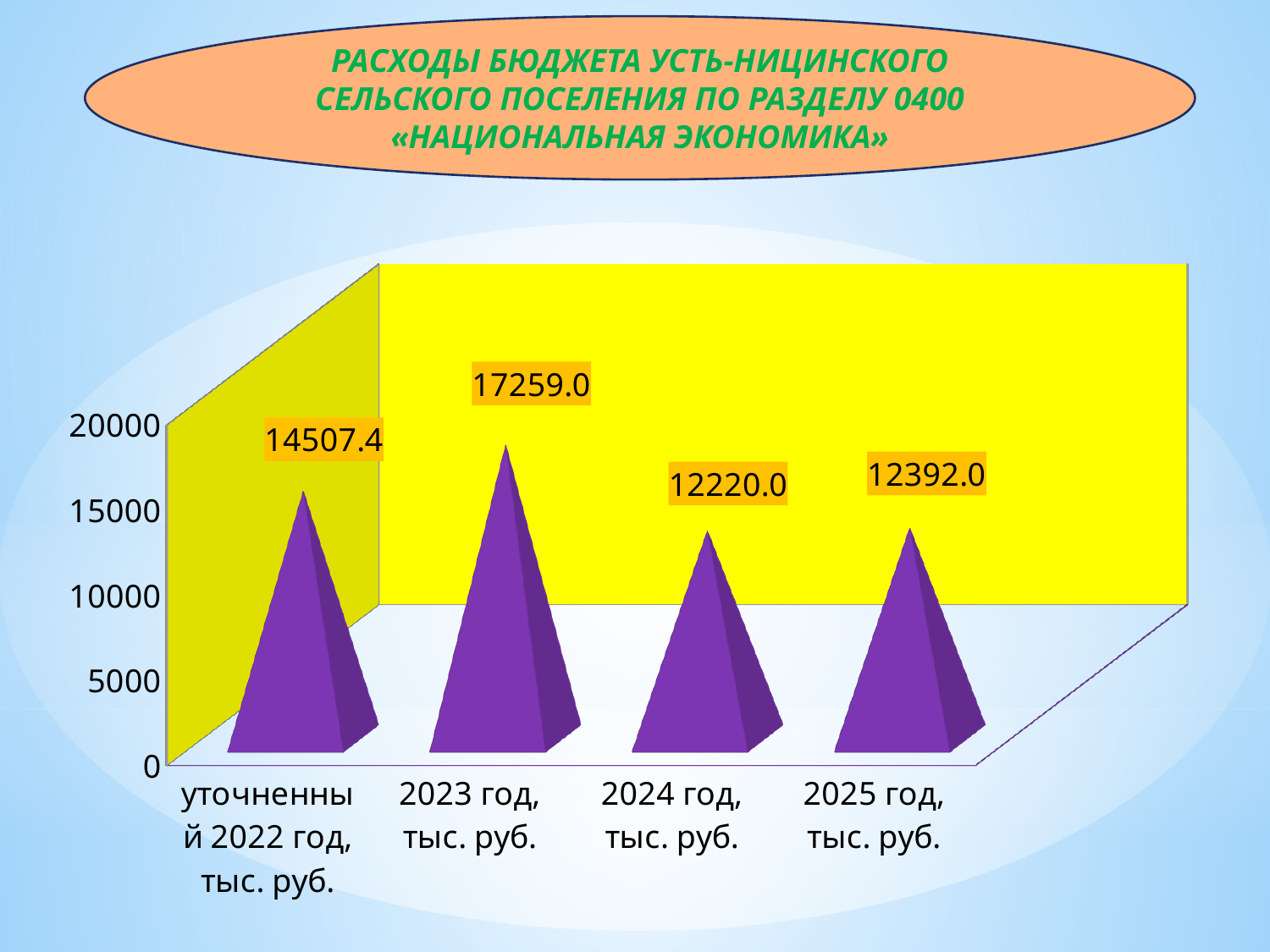
What is the difference between the values for 2025 год and 2024 год? 172.0 How many categories are shown on the chart? 4 Does the value rise or fall from 2023 год to 2024 год? fall What is the difference between the values for 2023 год and уточненный 2022 год? 2751.6 What kind of chart is shown on the slide? bar chart What is the value for 2023 год, тыс. руб.? 17259.0 What is the value for 2025 год, тыс. руб.? 12392.0 What is the value for уточненный 2022 год, тыс. руб.? 14507.4 Which category has the lowest value? 2024 год, тыс. руб. Is the value for 2023 год greater or less than 15000? greater Which category has the highest value? 2023 год, тыс. руб. Which is larger, the value for 2024 год or the value for 2025 год? 2025 год, тыс. руб.